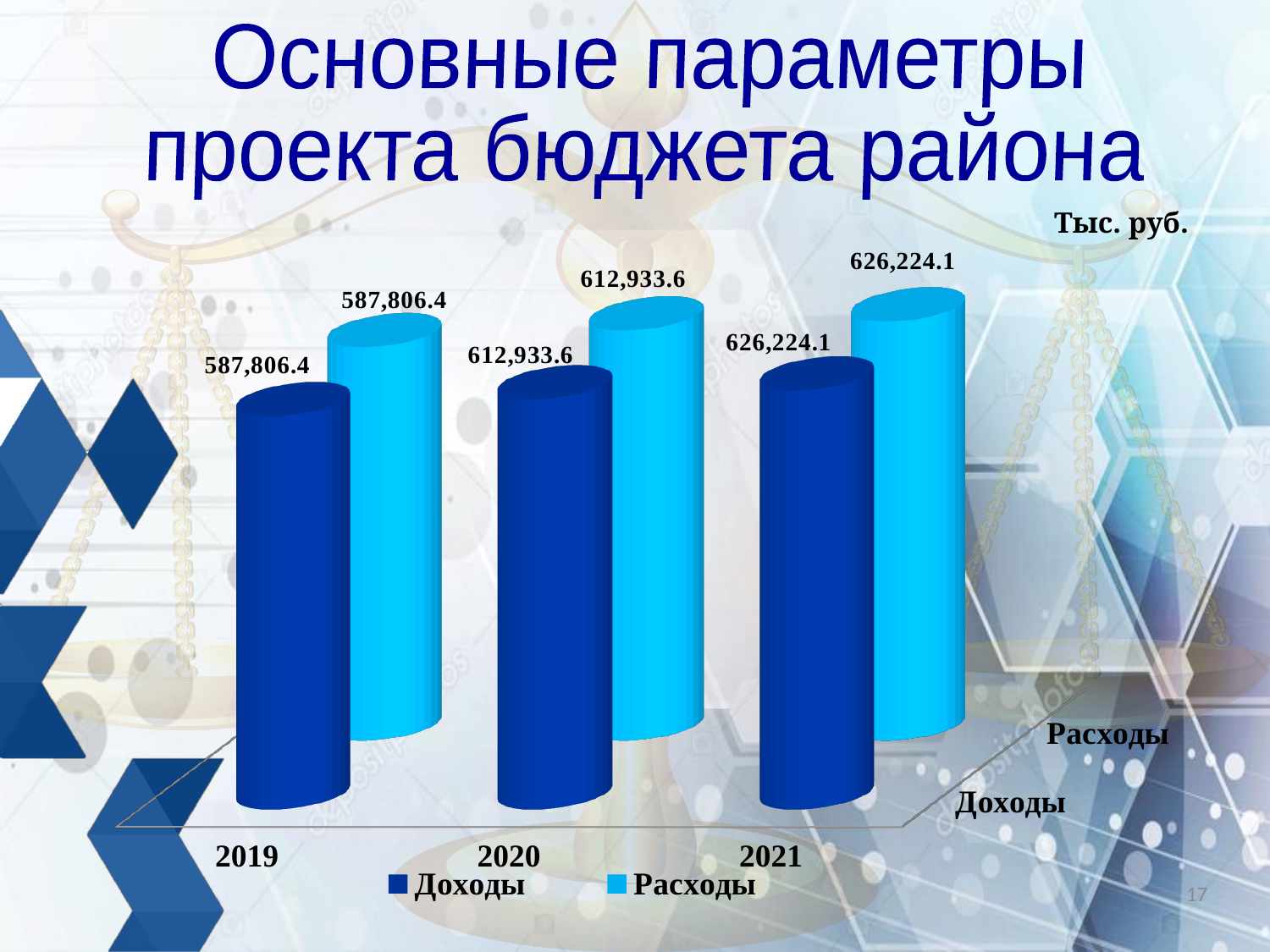
How many series does the legend list? 2 What is the value of Доходы for 2019? 587,806.4 Which is larger: Доходы in 2021 or Доходы in 2019? Доходы in 2021 Which year has the lowest value for Расходы? 2019 How many years are shown on the x axis of the chart? 3 Do the values for Расходы rise or fall from 2019 to 2021? rise What is the value of Расходы for 2021? 626,224.1 What is the difference between Доходы in 2020 and Доходы in 2019? 25,127.2 What is the difference between Расходы in 2021 and Расходы in 2020? 13,290.5 Which year has the highest value for Доходы? 2021 What is the value of Доходы for 2021? 626,224.1 What is the value of Расходы for 2020? 612,933.6